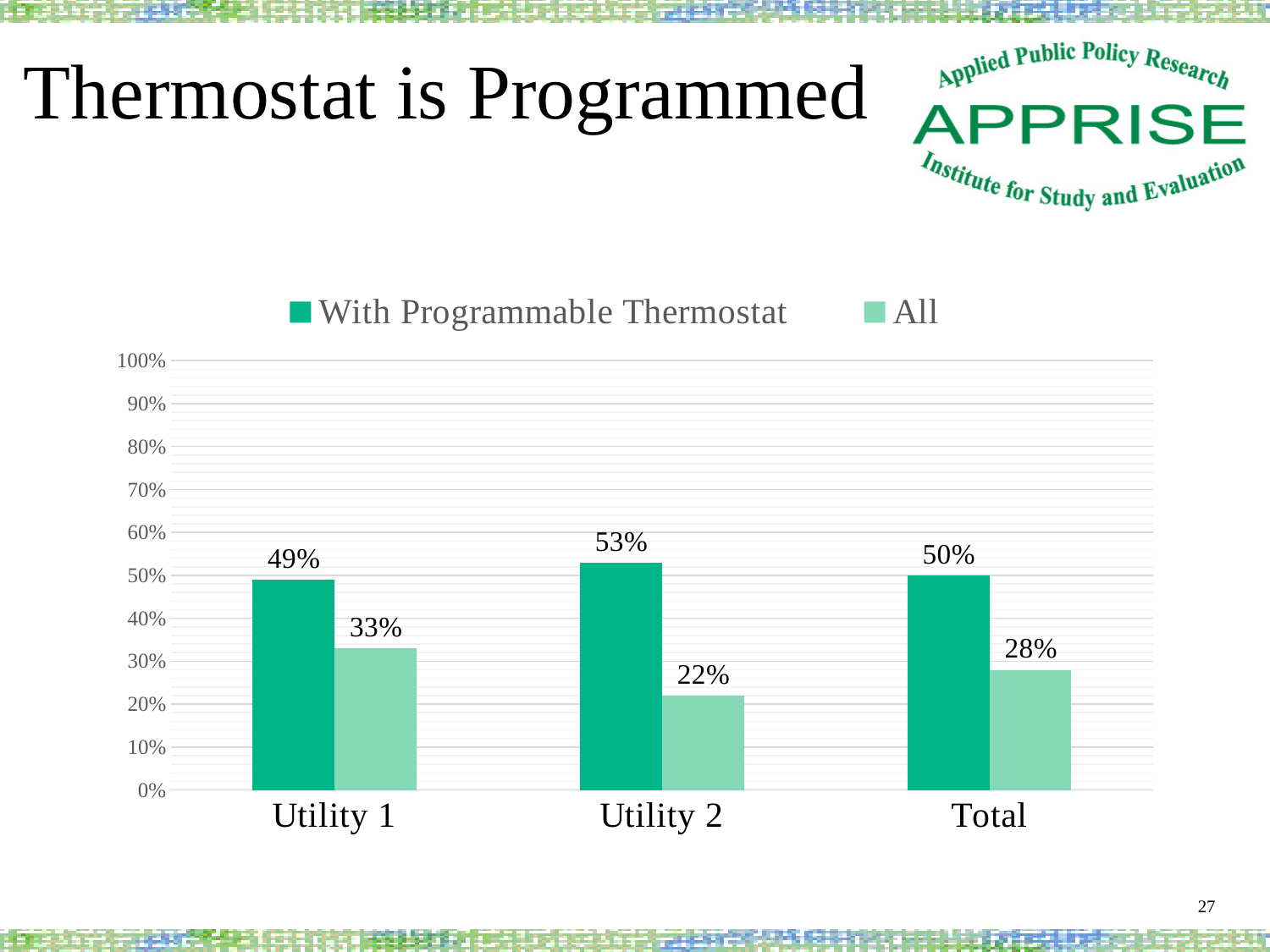
How many series does the legend list? 2 What is the value for Utility 2 in the All series? 22% What is the difference between the All values for Utility 1 and Total? 5% How many categories are shown on the x axis? 3 What kind of chart is shown on the slide? bar chart What is the difference between the With Programmable Thermostat and All values for Utility 2? 31% Which category has the lowest value in the All series? Utility 2 What is the value for Utility 1 in the With Programmable Thermostat series? 49% Is the With Programmable Thermostat value for Utility 2 greater or less than 60%? less Which category has the highest value in the With Programmable Thermostat series? Utility 2 Which is larger: the All value for Utility 1 or the All value for Total? Utility 1 What is the value for Total in the With Programmable Thermostat series? 50%